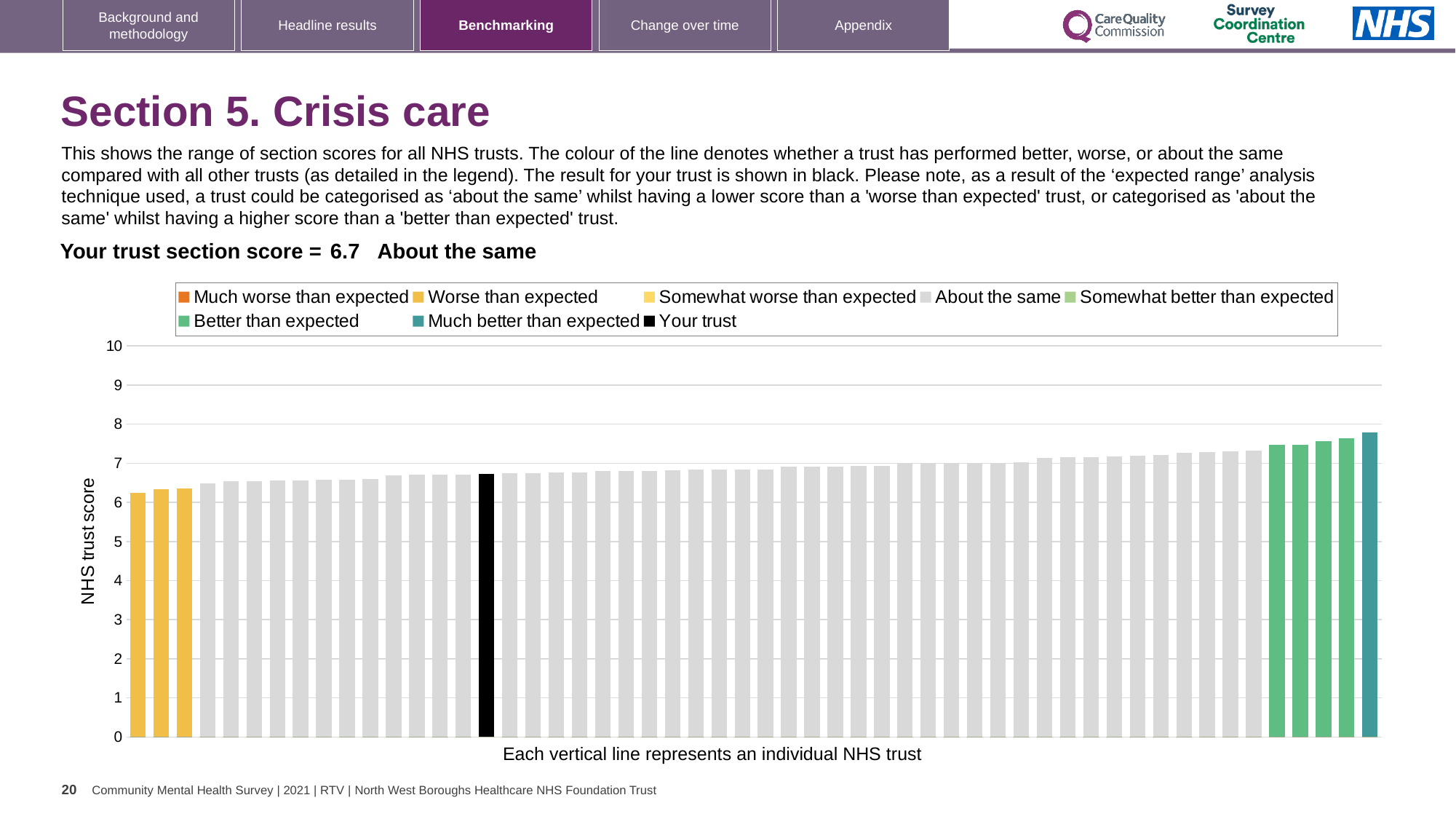
Is the value for your trust (the black bar) greater or less than 5? greater Which is larger: the value for your trust or the value of the rightmost (teal) bar? the rightmost (teal) bar What kind of chart is shown on the slide? bar chart How many entries does the legend list? 8 How many bars are coloured as 'Better than expected' (green)? 4 What is the section score for your trust? 6.7 What is the label on the vertical axis of the chart? NHS trust score Which performance category is your trust placed in for this section? About the same Is the shortest bar on the chart greater or less than 7? less Is the tallest bar on the chart greater or less than 7? greater Do the bar values rise or fall from left to right along the x axis? rise How many bars are coloured as 'Worse than expected' (yellow)? 3